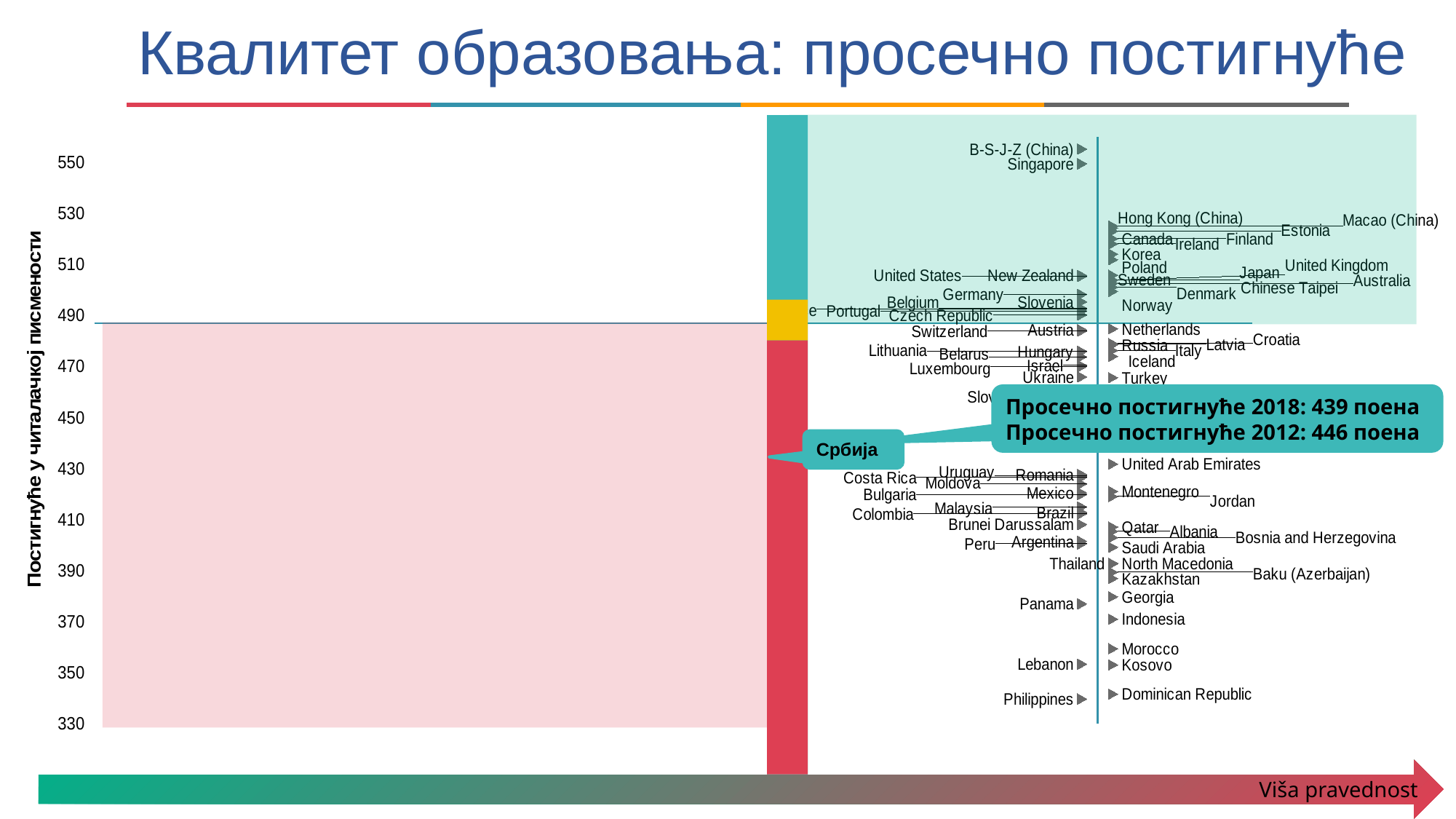
What kind of chart is shown on the slide? scatter chart What is the label of the vertical axis? Постигнуће у читалачкој писмености Is the value for Philippines greater or less than 350? less Is the value for Panama greater or less than 390? less Is the value for Singapore greater or less than 530? greater What is Serbia's average reading achievement in 2018 according to the callout on the chart? 439 поена Which country or economy has the highest reading achievement on the chart? B-S-J-Z (China) Which year shows the higher average achievement for Serbia, 2012 or 2018? 2012 What is Serbia's average reading achievement in 2012 according to the callout on the chart? 446 поена By how many points did Serbia's average achievement change between 2012 and 2018? 7 What is the title of the slide? Квалитет образовања: просечно постигнуће